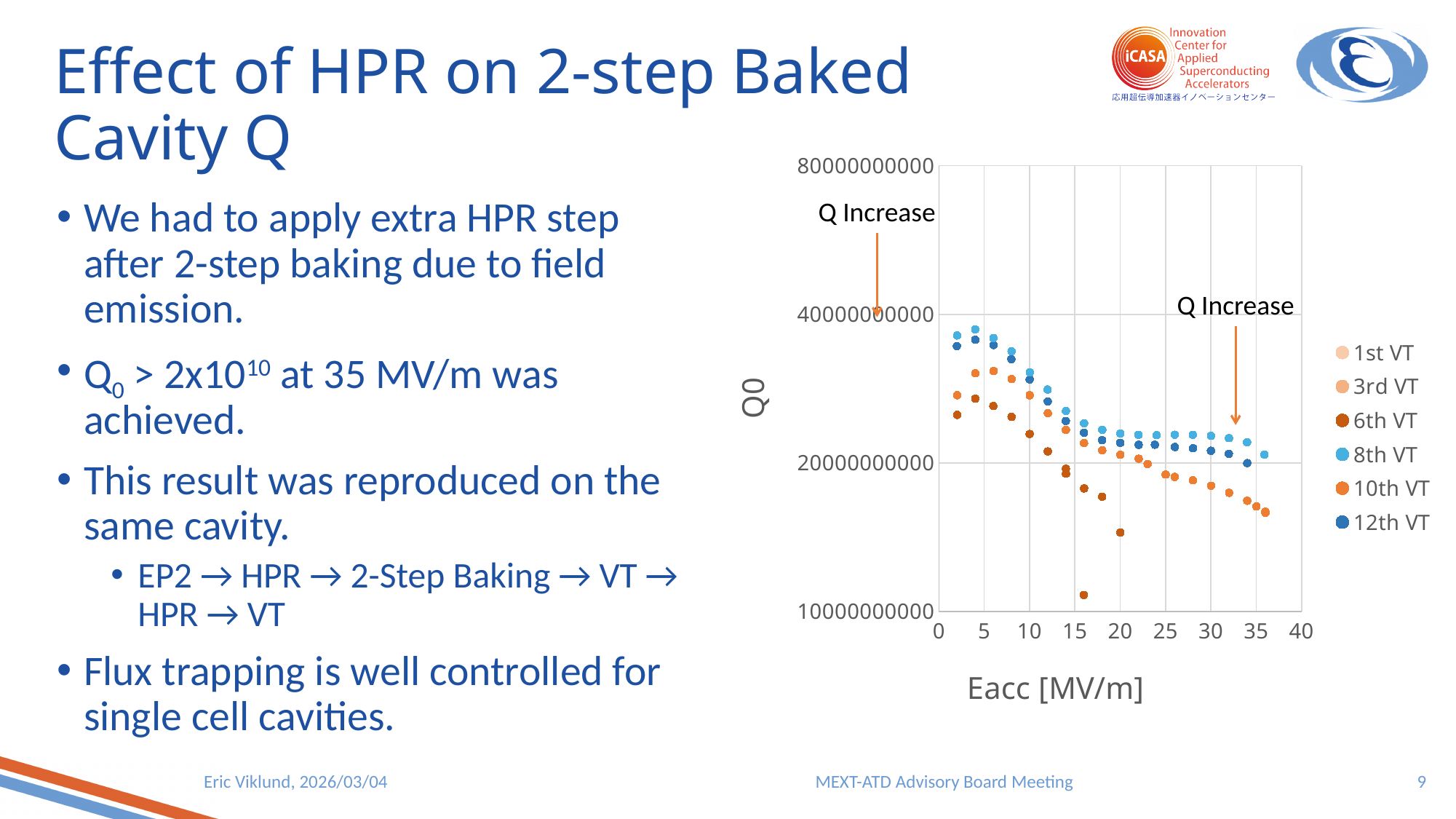
Does the Q0 of the 10th VT series rise or fall as Eacc increases? fall At 35 MV/m, which series has the higher Q0: 8th VT or 10th VT? 8th VT What kind of chart is shown on the slide? scatter chart Is the Q0 value for 8th VT at 35 MV/m greater or less than 20000000000? greater Is the Q0 value for 10th VT at 35 MV/m greater or less than 20000000000? less How many series does the chart legend list? 6 What is the label of the y axis of the chart? Q0 What is the label of the x axis of the chart? Eacc [MV/m] Does the Q0 of the 8th VT series rise or fall overall as Eacc increases from 2 to 36 MV/m? fall Is the lowest Q0 point of the 6th VT series greater or less than 20000000000? less